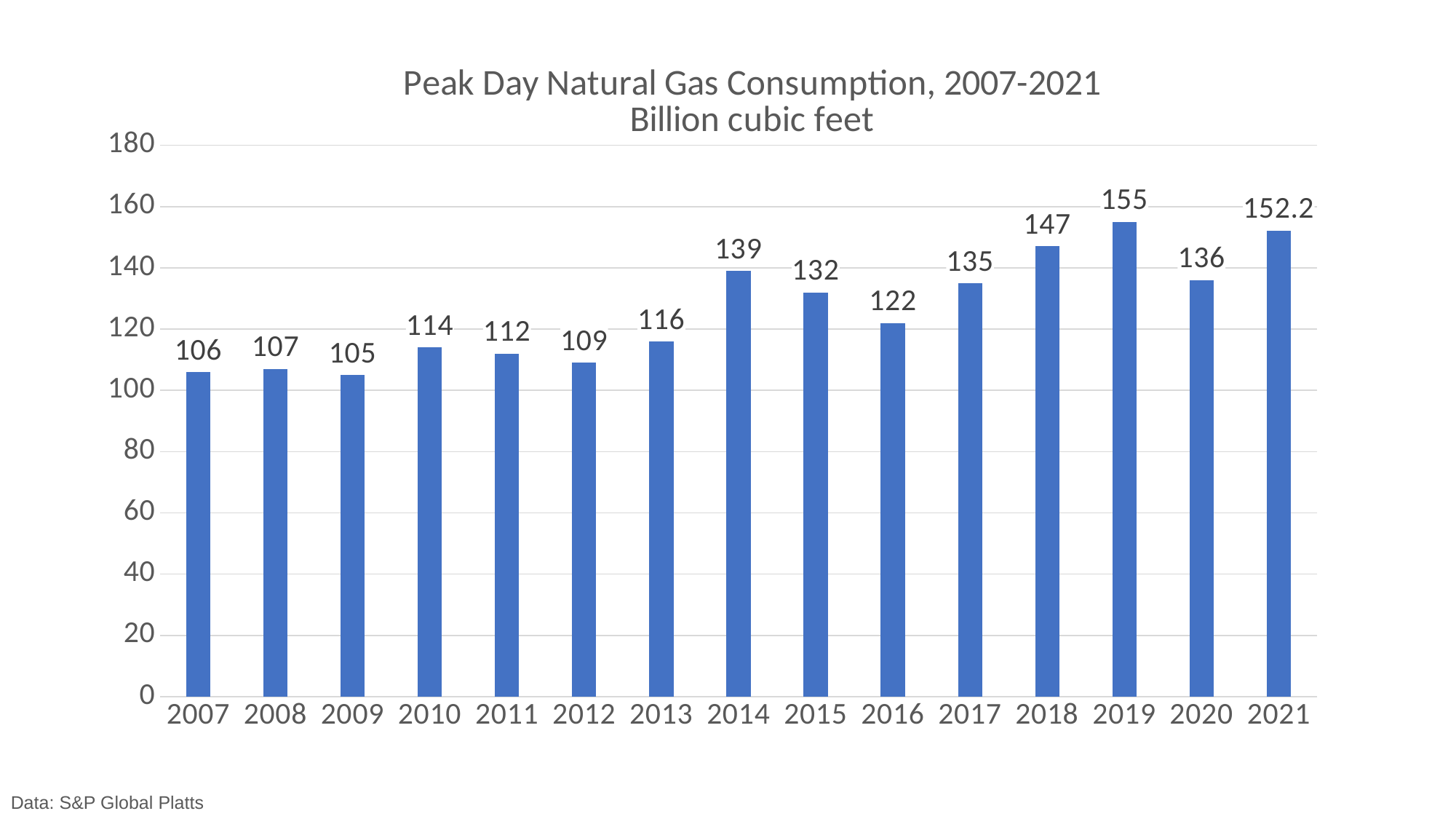
What kind of chart is shown on the slide? bar chart Is the value for 2016 greater or less than 140? less What is the difference between the values for 2018 and 2007? 41 What is the difference between the values for 2019 and 2020? 19 What is the value shown for 2021? 152.2 What is the value shown for 2009? 105 Which year has the lowest peak day natural gas consumption? 2009 Which year has a larger value, 2015 or 2017? 2017 Which year has the highest peak day natural gas consumption? 2019 What is the peak day natural gas consumption value for 2014? 139 What is the title of the chart? Peak Day Natural Gas Consumption, 2007-2021 Billion cubic feet How many years are shown on the x axis? 15